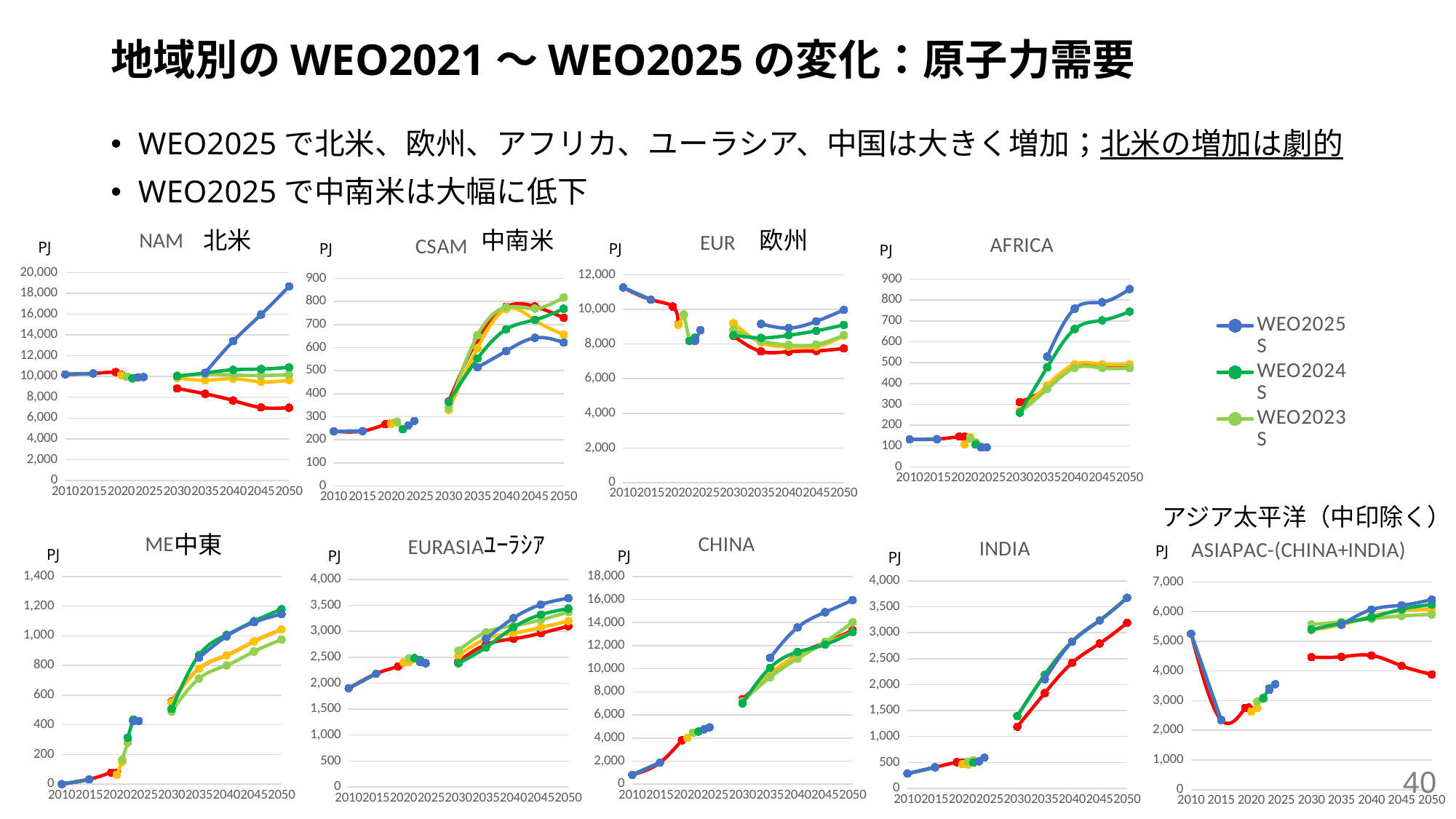
In the NAM (北米) chart, which is larger in 2050: the WEO2025S line or the red line? WEO2025S In the EUR (欧州) chart, is the WEO2025S value in 2010 greater or less than 10,000? greater In the CSAM (中南米) chart, is the WEO2025S value in 2050 greater or less than 700? less How many series does the legend on the slide list? 3 What kind of chart is used for the NAM (北米) panel? line chart In the ME (中東) chart, does the WEO2025S line rise or fall from 2030 to 2050? rises What unit is shown on the vertical axis of the charts? PJ In the EURASIA chart, is the WEO2025S value in 2050 greater or less than 3,500? greater How many regional charts are shown on the slide? 9